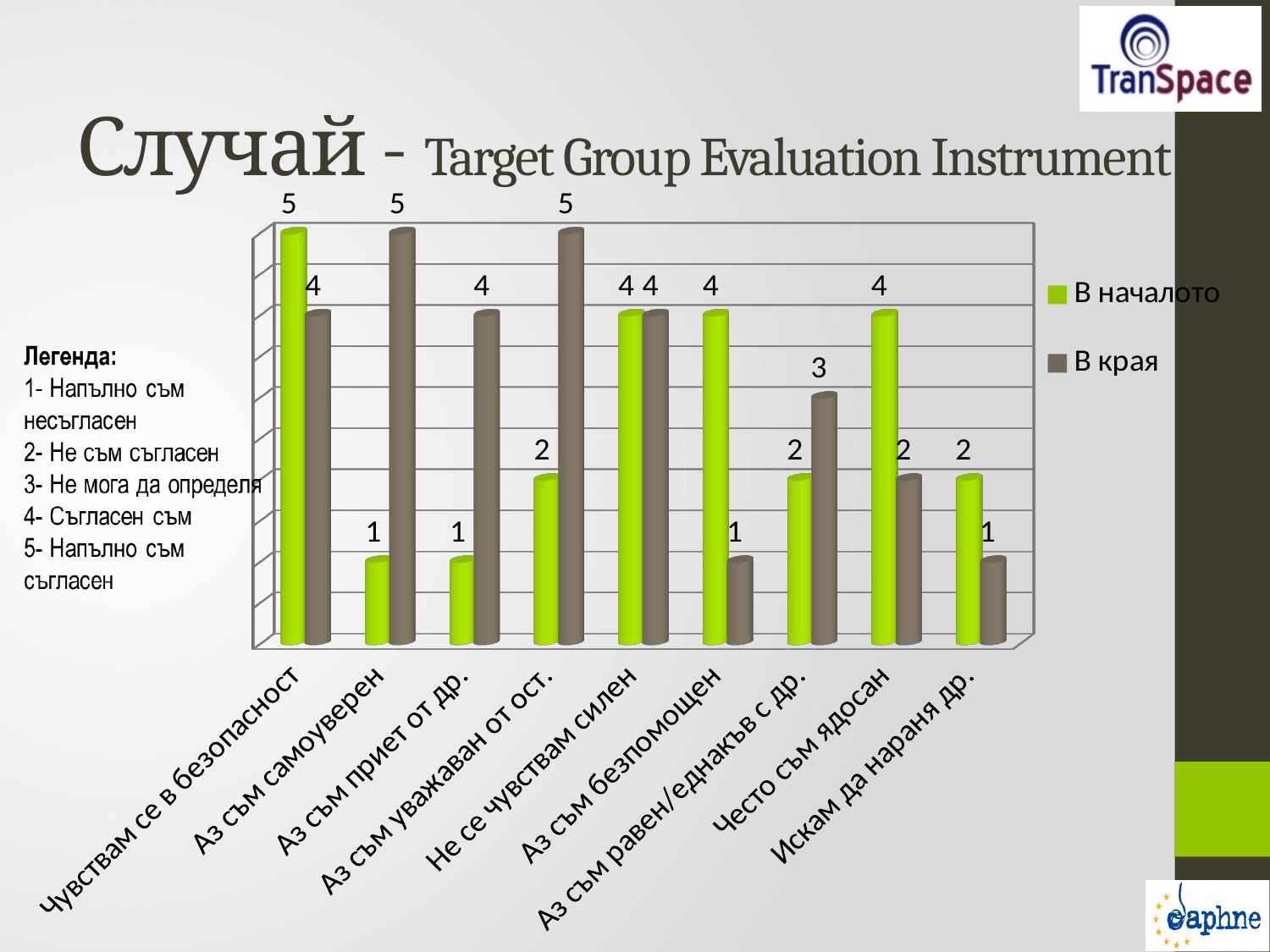
What is the value for "Често съм ядосан" in the "В началото" series? 4 How many categories are shown on the x axis of the chart? 9 How many series does the chart legend list? 2 What kind of chart is shown on the slide? Bar chart For "Често съм ядосан", which is larger: the "В началото" value or the "В края" value? В началото Which category has the lowest value in the "В края" series? Аз съм безпомощен and Искам да нараня др. (both 1) What is the difference between the "В началото" and "В края" values for "Аз съм безпомощен"? 3 For "Аз съм приет от др.", which is larger: the "В началото" value or the "В края" value? В края What is the value for "Аз съм самоуверен" in the "В края" series? 5 What is the value for "Аз съм равен/еднакъв с др." in the "В края" series? 3 What is the difference between the "В началото" and "В края" values for "Аз съм самоуверен"? 4 What is the value for "Искам да нараня др." in the "В началото" series? 2